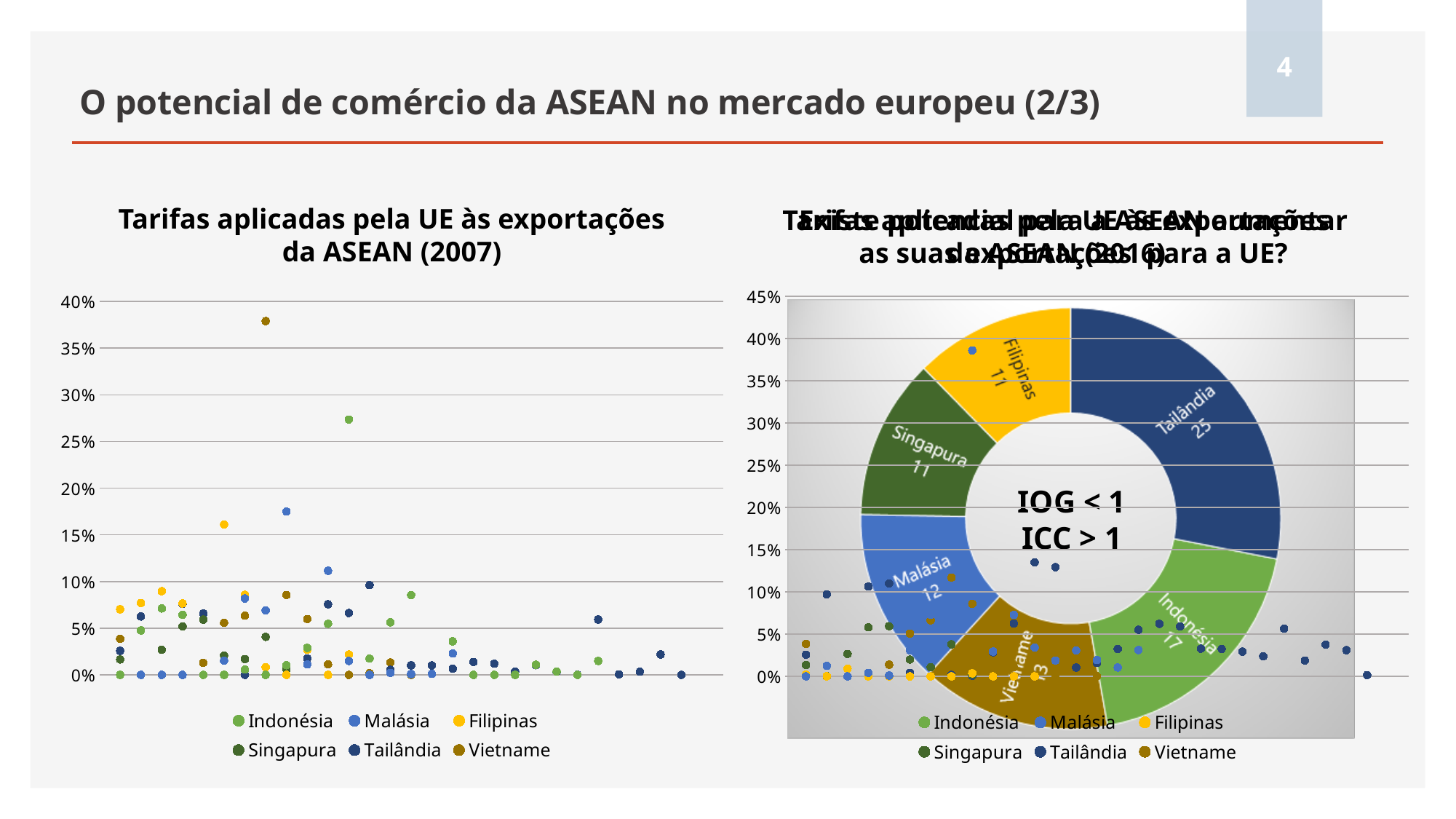
How many series does the legend of the left chart (2007) list? 6 In the doughnut chart on the right side of the slide, which country has the largest segment? Tailândia In the left chart (2007), is the highest plotted point greater or less than 35%? greater In the doughnut chart on the right side of the slide, what is the value for Vietname? 13 What is the maximum value shown on the y axis of the left chart (2007)? 40% In the doughnut chart on the right side of the slide, what is the value for Indonésia? 17 In the left chart (2007), which series does the highest plotted point belong to? Vietname In the doughnut chart on the right side of the slide, what is the difference between the values for Tailândia and Indonésia? 8 How many segments does the doughnut chart on the right side of the slide have? 6 In the doughnut chart on the right side of the slide, which is larger, the value for Malásia or the value for Vietname? Vietname What kind of chart is the left chart titled 'Tarifas aplicadas pela UE às exportações da ASEAN (2007)'? Scatter chart In the doughnut chart on the right side of the slide, what is the value for Tailândia? 25